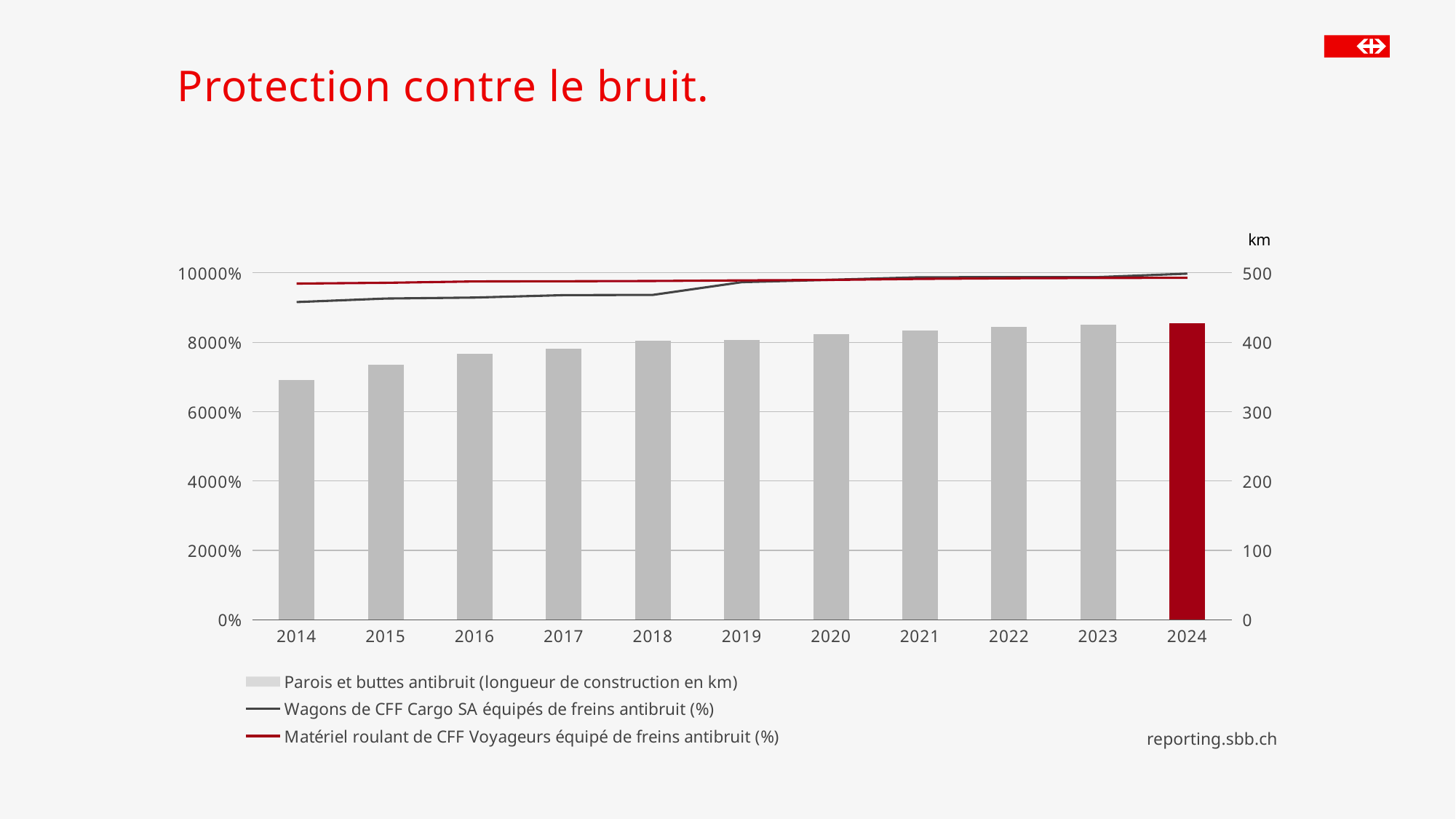
Which is larger, the bar for 2014 or the bar for 2024? 2024 How many years are shown on the x axis of the chart? 11 What kind of chart is shown on the slide? A combined bar and line chart Which year has the lowest bar for 'Parois et buttes antibruit (longueur de construction en km)'? 2014 What is the title of the slide? Protection contre le bruit. Do the bars for 'Parois et buttes antibruit' rise or fall from 2014 to 2024? Rise Is the 2024 value for 'Parois et buttes antibruit' greater or less than 400 km? greater In 2014, which line is higher: 'Wagons de CFF Cargo SA équipés de freins antibruit (%)' or 'Matériel roulant de CFF Voyageurs équipé de freins antibruit (%)'? Matériel roulant de CFF Voyageurs équipé de freins antibruit (%) Which year has the highest bar for 'Parois et buttes antibruit (longueur de construction en km)'? 2024 Is the 2014 value for 'Parois et buttes antibruit' greater or less than 400 km? less How many series does the legend list? 3 Is the 2016 value for 'Parois et buttes antibruit' greater or less than 400 km? less